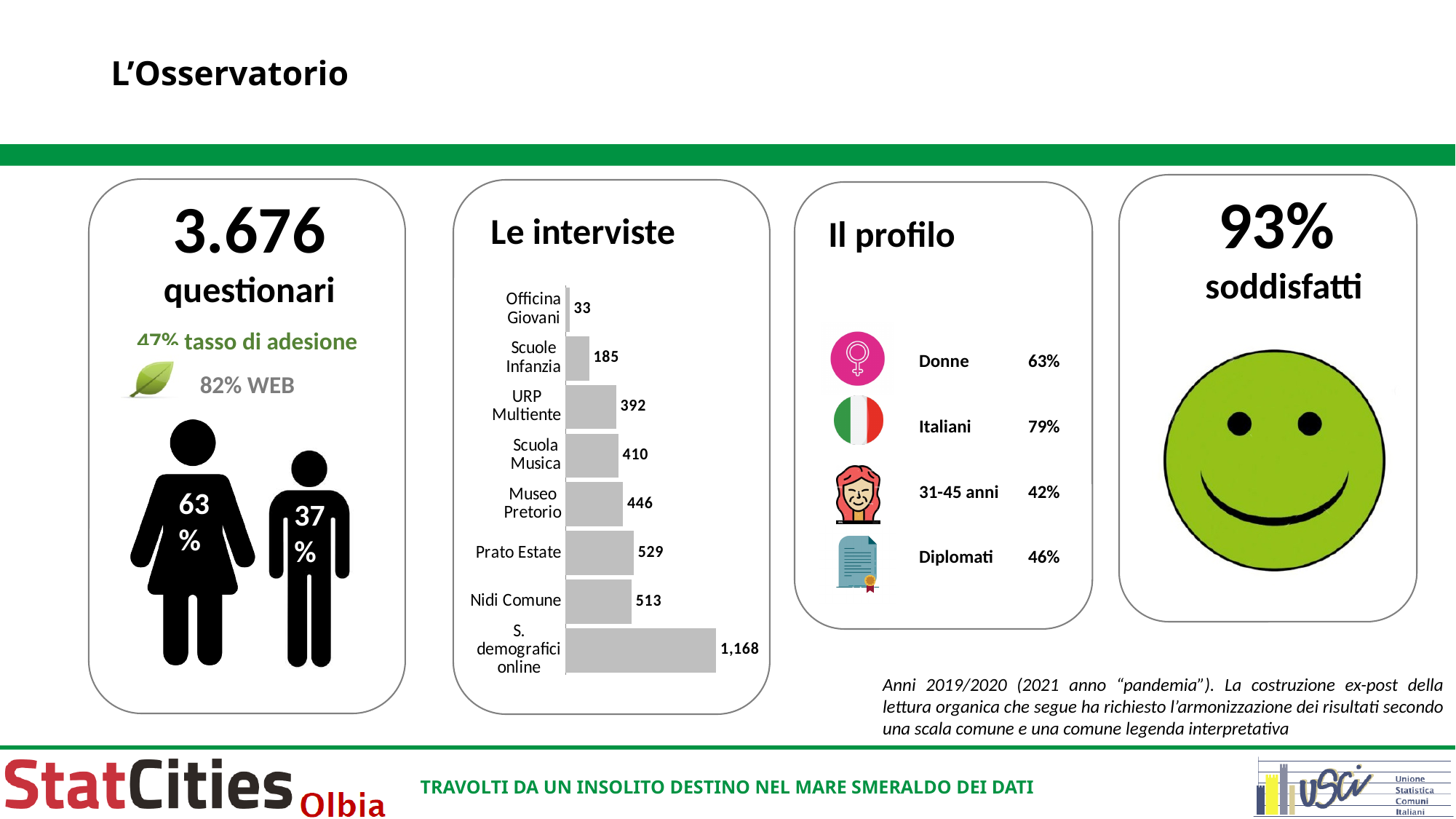
In the "Le interviste" chart, what is the difference between Prato Estate and Nidi Comune? 16 In the "Le interviste" chart, what is the value for Museo Pretorio? 446 What is the title of the bar chart on the slide? Le interviste What kind of chart is shown under "Le interviste"? bar chart How many categories are shown in the "Le interviste" chart? 8 In the "Le interviste" chart, which category has the lowest value? Officina Giovani In the "Le interviste" chart, what is the value for Nidi Comune? 513 In the "Le interviste" chart, what is the difference between Scuola Musica and URP Multiente? 18 In the "Le interviste" chart, what is the value for Scuole Infanzia? 185 In the "Le interviste" chart, what is the value for S. demografici online? 1,168 In the "Le interviste" chart, which category has the highest value? S. demografici online In the "Le interviste" chart, which is larger: Museo Pretorio or Scuola Musica? Museo Pretorio